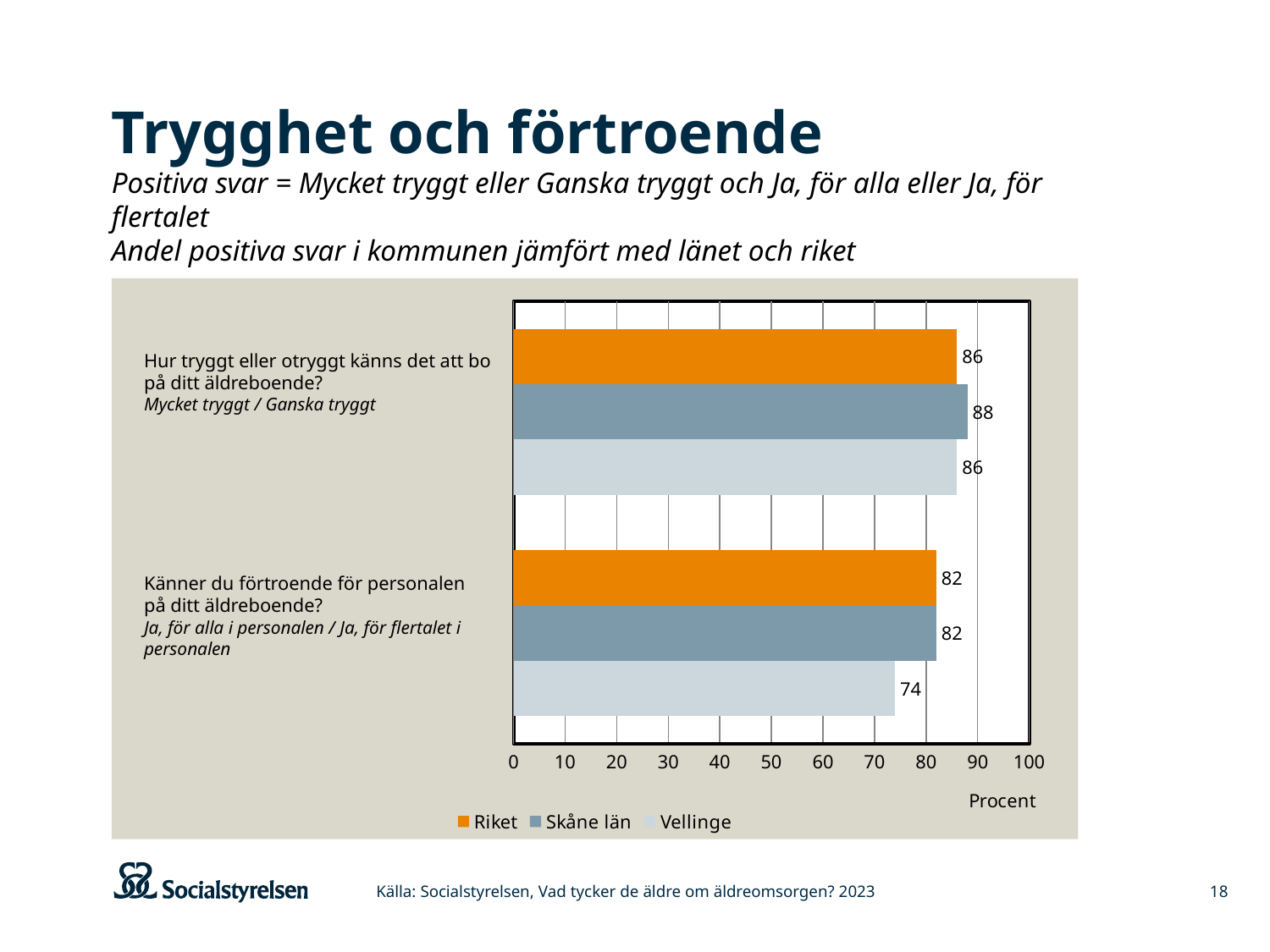
How many series does the legend list? 3 What unit is shown on the x axis of the chart? Procent Which series has the lowest value on the question "Känner du förtroende för personalen på ditt äldreboende?"? Vellinge What is the difference between the Skåne län and Riket values on the question "Hur tryggt eller otryggt känns det att bo på ditt äldreboende?"? 2 What kind of chart is shown on the slide? bar chart What is the value for Vellinge on the question "Känner du förtroende för personalen på ditt äldreboende?"? 74 What is the value for Riket on the question "Känner du förtroende för personalen på ditt äldreboende?"? 82 Is the Vellinge value higher for "Hur tryggt eller otryggt känns det att bo på ditt äldreboende?" or for "Känner du förtroende för personalen på ditt äldreboende?"? Hur tryggt eller otryggt känns det att bo på ditt äldreboende? What is the difference between the Riket and Vellinge values on the question "Känner du förtroende för personalen på ditt äldreboende?"? 8 What is the value for Skåne län on the question "Hur tryggt eller otryggt känns det att bo på ditt äldreboende?"? 88 Which series has the highest value on the question "Hur tryggt eller otryggt känns det att bo på ditt äldreboende?"? Skåne län Is the value for Vellinge on the question "Känner du förtroende för personalen på ditt äldreboende?" greater or less than 80? less